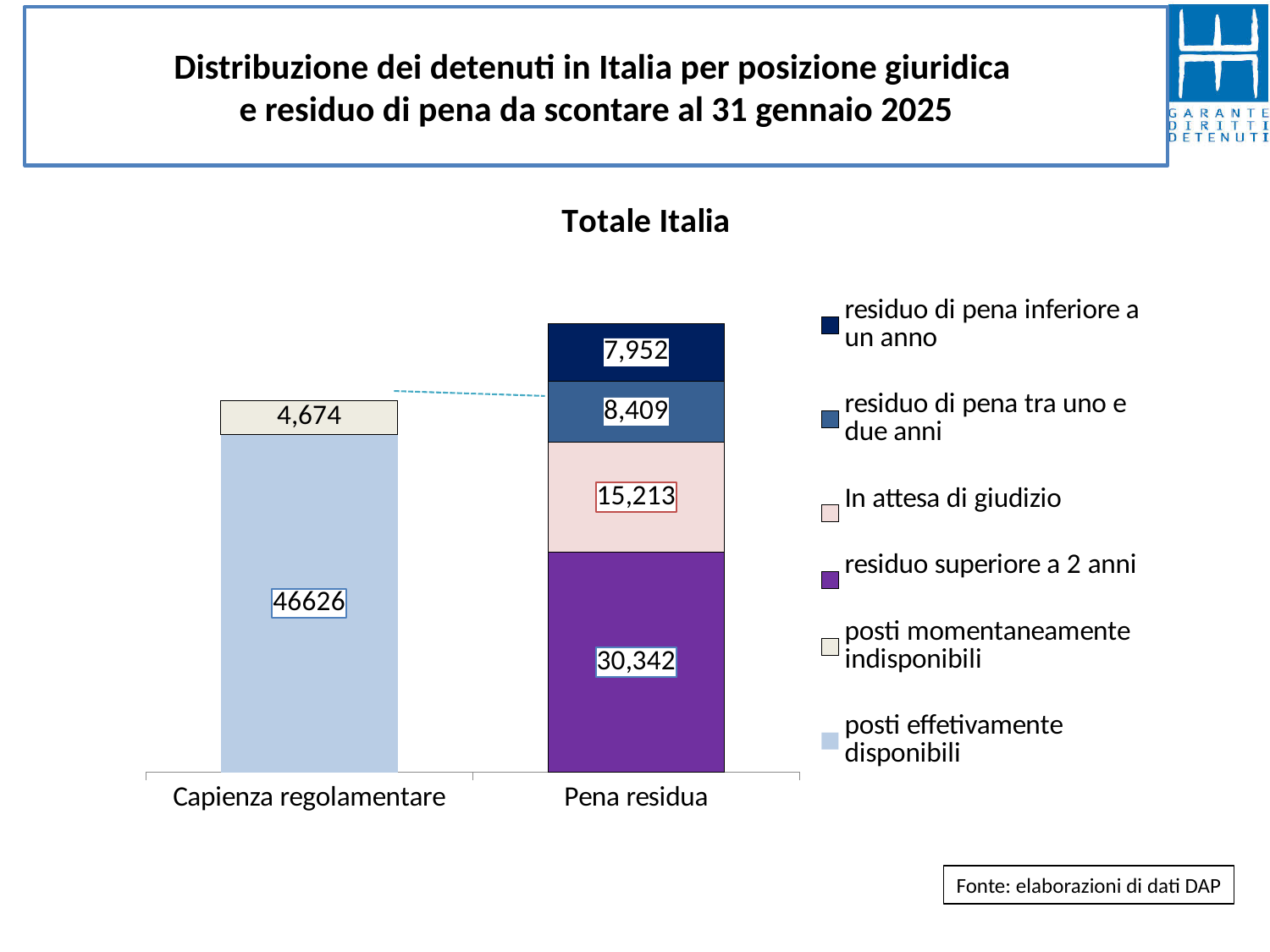
Which segment of the 'Pena residua' bar has the largest value? residuo superiore a 2 anni What is the value of 'residuo di pena tra uno e due anni' in the 'Pena residua' bar? 8,409 What is the value of 'residuo di pena inferiore a un anno' in the 'Pena residua' bar? 7,952 What is the total of the 'Pena residua' stacked bar? 61,916 What is the value of 'posti momentaneamente indisponibili' in the 'Capienza regolamentare' bar? 4,674 What is the difference between 'residuo di pena tra uno e due anni' and 'residuo di pena inferiore a un anno' in the 'Pena residua' bar? 457 What is the value of 'posti effettivamente disponibili' in the 'Capienza regolamentare' bar? 46626 How many series does the legend list? 6 What kind of chart is shown on the slide? Stacked bar chart What is the title of the chart? Totale Italia What is the value of 'In attesa di giudizio' in the 'Pena residua' bar? 15,213 How many bars (categories) are shown on the x axis? 2